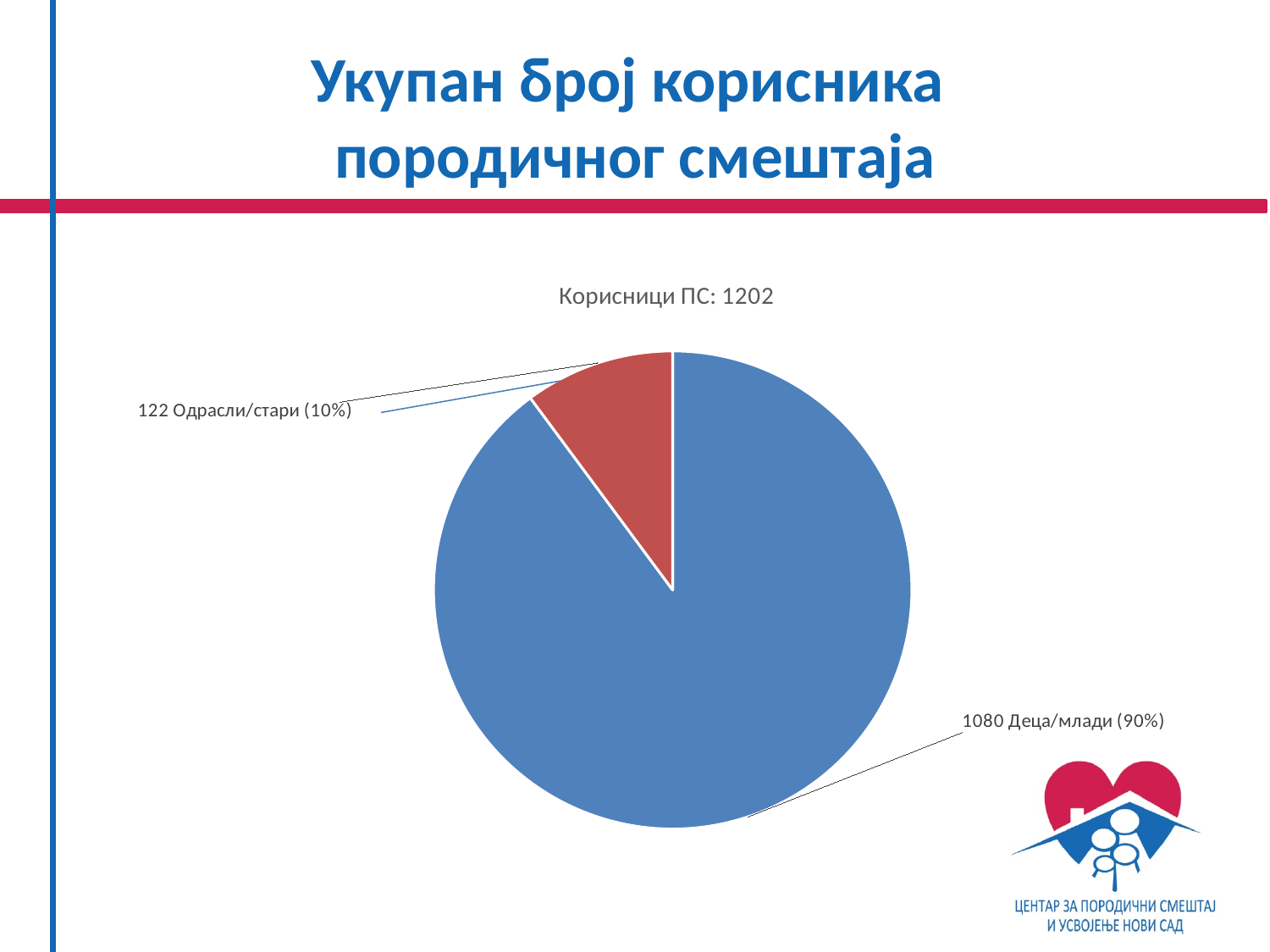
What share of the pie does Деца/млади represent? 90% Which category has the largest slice? Деца/млади What is the difference between the values for Деца/млади and Одрасли/стари? 958 How many slices does the pie chart have? 2 What is the value for Деца/млади? 1080 What is the title of the chart? Корисници ПС: 1202 What is the value for Одрасли/стари? 122 What share of the pie does Одрасли/стари represent? 10% What kind of chart is shown on the slide? pie chart Which is larger, the value for Деца/млади or the value for Одрасли/стари? Деца/млади What colour is the slice for Одрасли/стари? red Which category has the smallest slice? Одрасли/стари